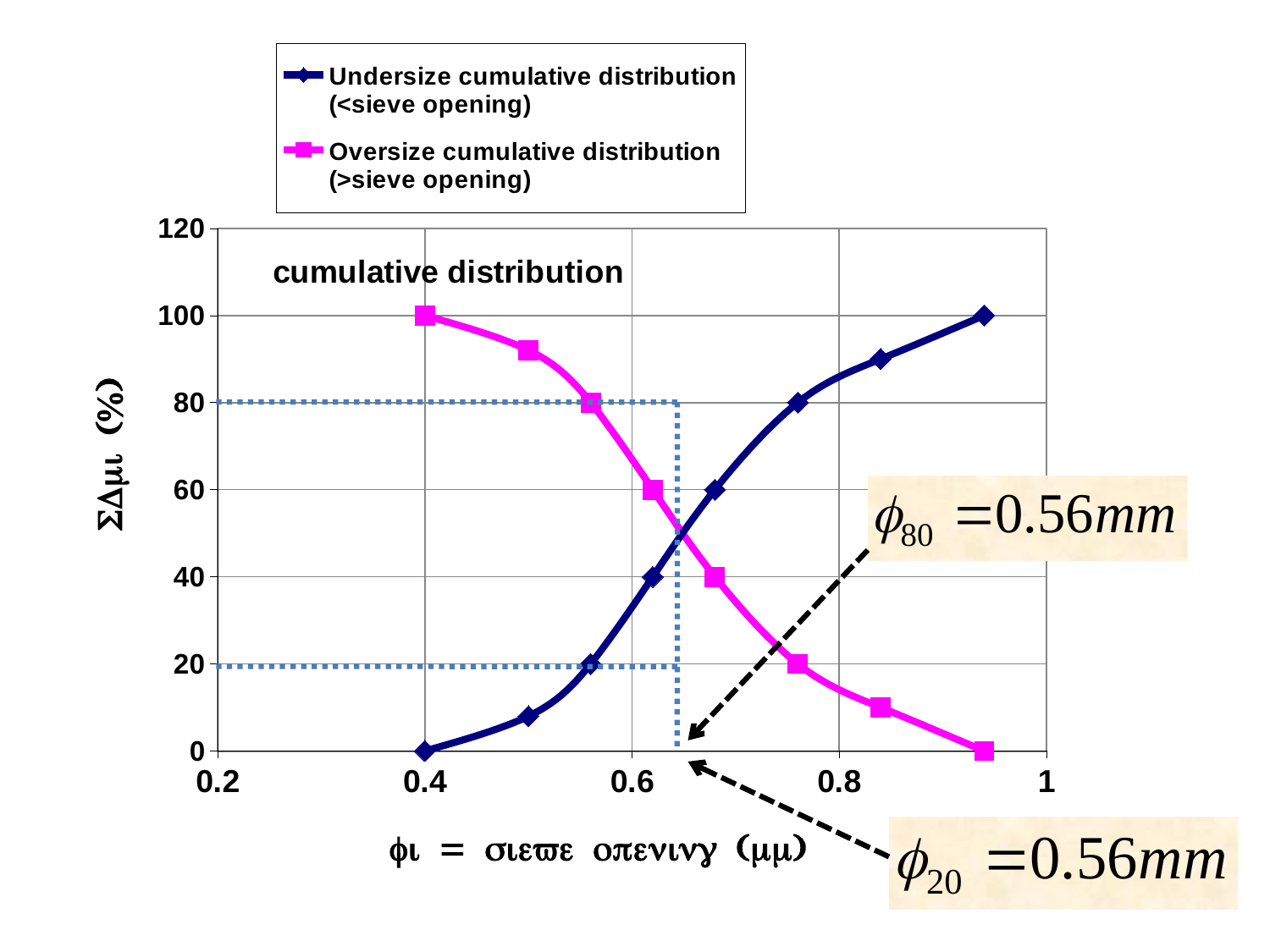
What is the maximum value reached by the Undersize cumulative distribution series? 100 At a sieve opening of 0.8, which series has the larger value, Undersize or Oversize cumulative distribution? Undersize cumulative distribution Does the Oversize cumulative distribution rise or fall as the sieve opening increases? fall What is the minimum value reached by the Oversize cumulative distribution series? 0 What is the value of the Undersize cumulative distribution at a sieve opening of 0.4? 0 Does the Undersize cumulative distribution rise or fall as the sieve opening increases? rise How many data points are plotted for the Undersize cumulative distribution series? 8 What is the value of the Oversize cumulative distribution at a sieve opening of 0.4? 100 According to the annotation on the slide, what is the value of φ80? 0.56mm Is the value of the Oversize cumulative distribution at a sieve opening of 0.8 greater or less than 20? less What kind of chart is shown on the slide? line chart How many series does the legend list? 2